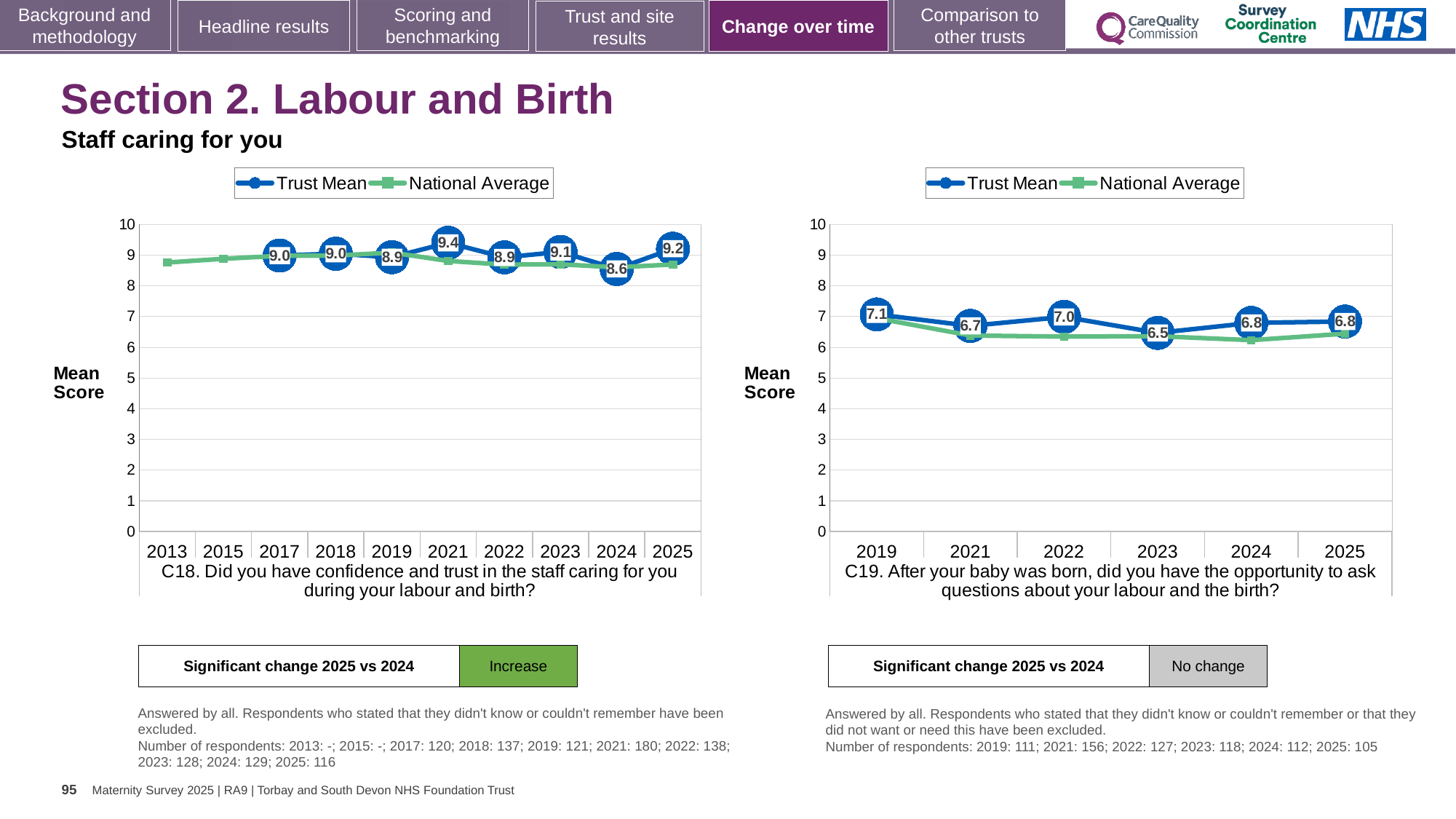
In the C18 chart (left), which year has the lowest Trust Mean? 2024 In the C18 chart (left), how many series does the legend list? 2 In the C18 chart (left), which year has the highest Trust Mean? 2021 In the C18 chart (left), what is the difference between the Trust Mean for 2025 and 2024? 0.6 In the C19 chart (right), is the Trust Mean for 2022 or 2023 larger? 2022 What kind of chart is the C19 chart (right)? Line chart In the C19 chart (right), is the National Average for 2024 greater or less than 7? less In the C19 chart (right), what is the Trust Mean for 2019? 7.1 In the C19 chart (right), how many years are shown on the x axis? 6 In the C19 chart (right), which year has the lowest Trust Mean? 2023 In the C18 chart (left), what is the Trust Mean for 2025? 9.2 In the C18 chart (left), what is the Trust Mean for 2024? 8.6